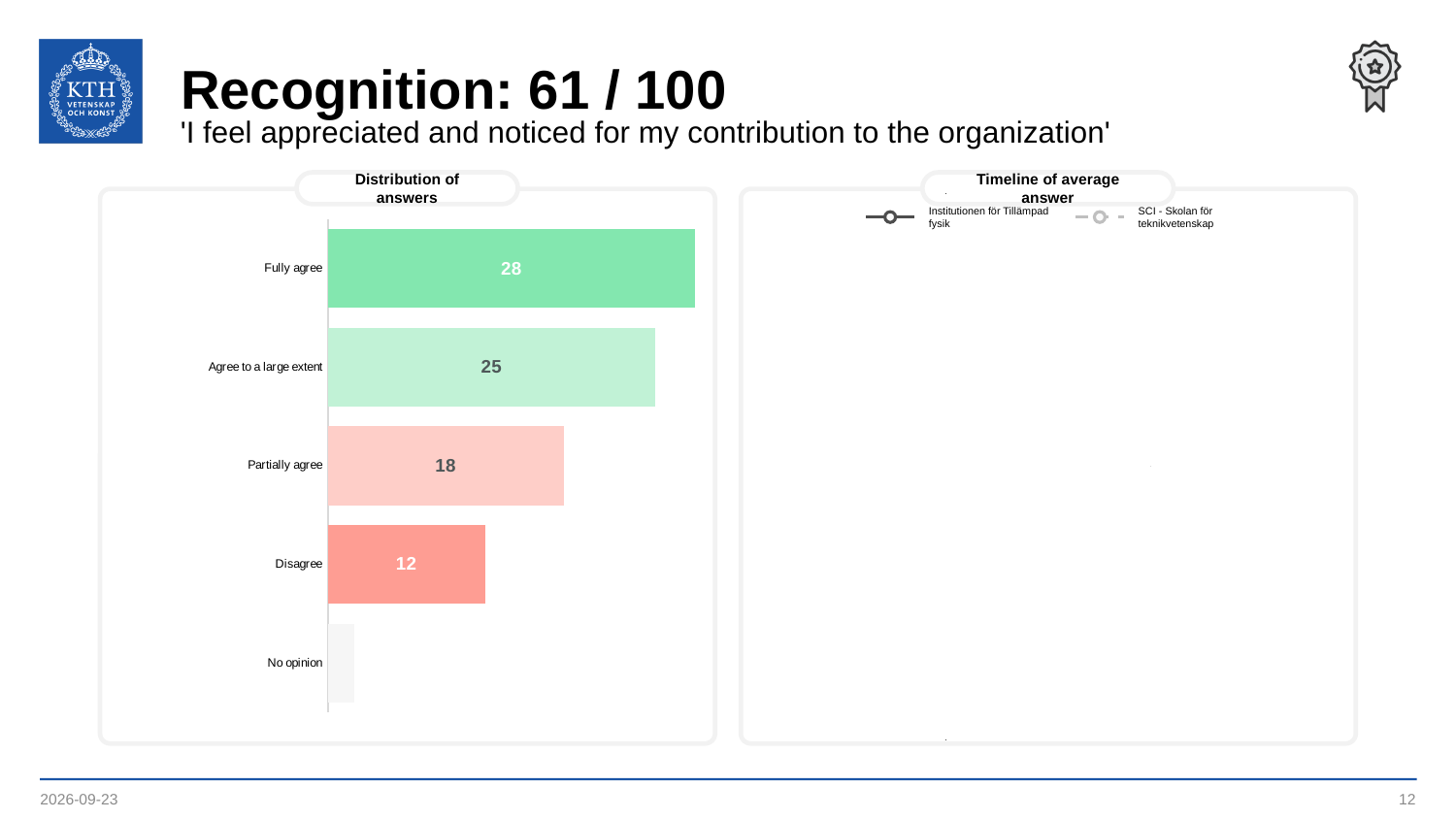
How many series does the legend of the 'Timeline of average answer' chart list? 2 In the 'Distribution of answers' chart, what is the value for 'Fully agree'? 28 How many categories are shown in the 'Distribution of answers' chart? 5 In the 'Distribution of answers' chart, which category has the highest value? Fully agree In the 'Distribution of answers' chart, which is larger: 'Agree to a large extent' or 'Partially agree'? Agree to a large extent In the 'Distribution of answers' chart, what is the value for 'Partially agree'? 18 In the 'Distribution of answers' chart, what is the difference between 'Fully agree' and 'Disagree'? 16 In the 'Timeline of average answer' chart, what is the name of the second legend entry? SCI - Skolan för teknikvetenskap In the 'Distribution of answers' chart, what is the value for 'Agree to a large extent'? 25 What kind of chart is the 'Distribution of answers' chart? Bar chart In the 'Distribution of answers' chart, which category has the lowest value? No opinion In the 'Distribution of answers' chart, what is the value for 'Disagree'? 12